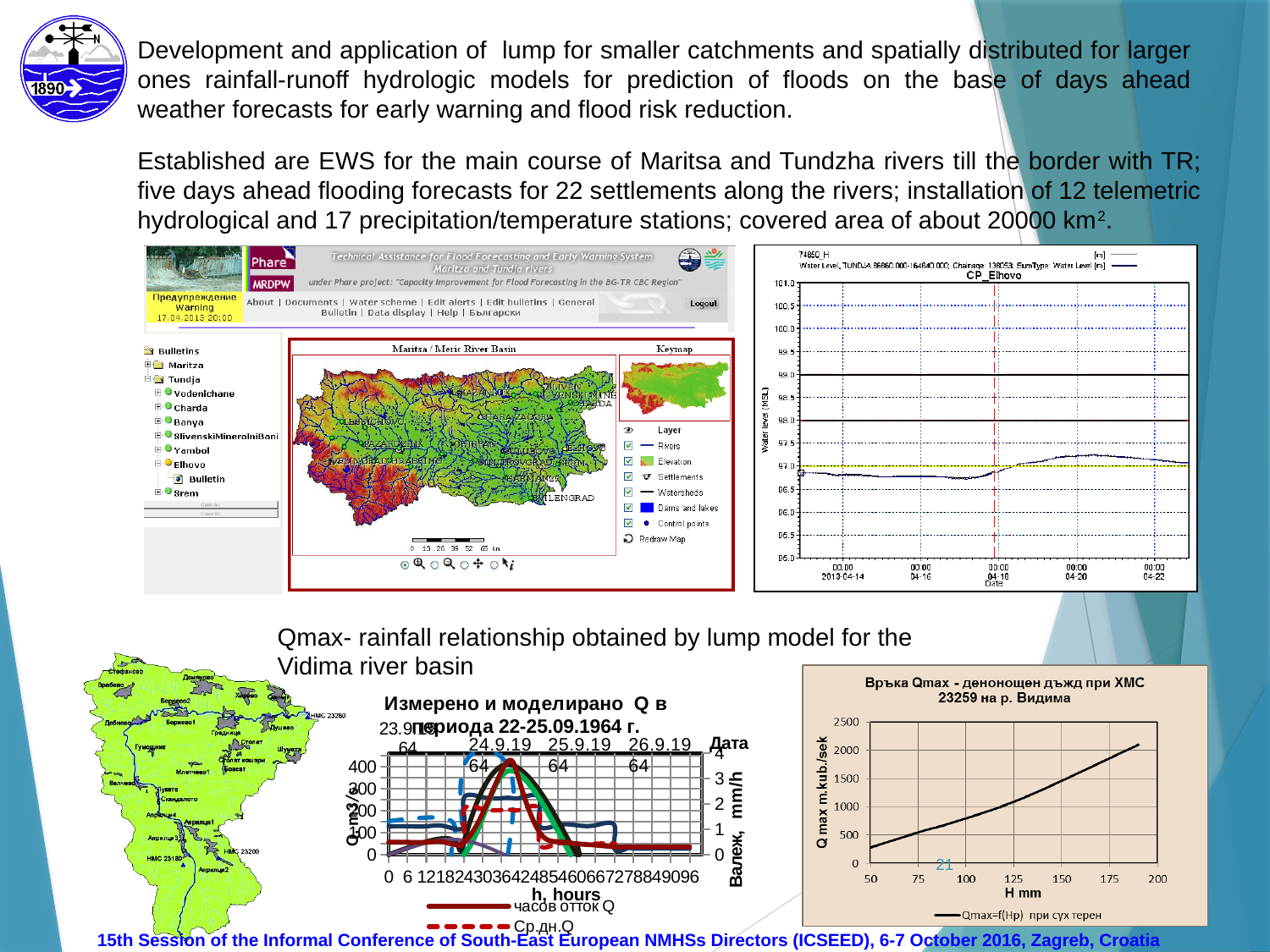
In the top-right chart 'CP_Elhovo', is the water level on 2013-04-14 greater or less than 99.0? less What is the x-axis label of the bottom-middle chart 'Измерено и моделирано Q'? h, hours What kind of chart is the bottom-right chart titled 'Връзка Qmax - денонощен дъжд при ХМС 23259 на р. Видима'? line chart In the bottom-right chart 'Връзка Qmax - денонощен дъжд', is the Qmax value at H = 50 mm greater or less than 500? less In the top-right chart 'CP_Elhovo', is the water level on 2013-04-20 greater or less than 98.0? less What kind of chart is the top-right chart titled 'CP_Elhovo'? line chart In the bottom-right chart 'Връзка Qmax - денонощен дъжд', does Qmax rise or fall as H mm increases along the x axis? rises In the bottom-right chart 'Връзка Qmax - денонощен дъжд', what is the legend entry for the plotted line? Qmax=f(Hp) при сух терен